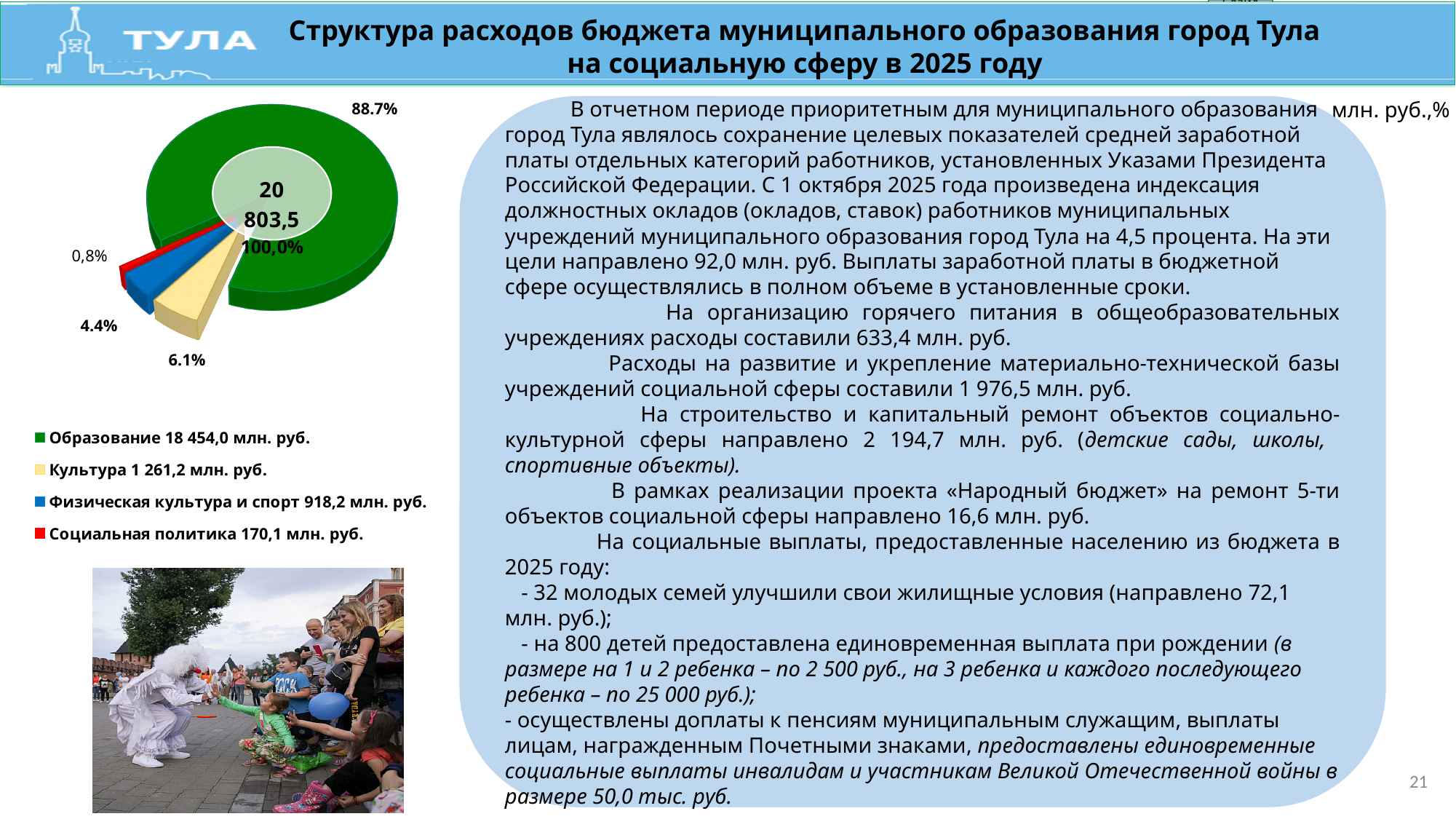
What total value is printed in the centre of the pie chart? 20 803,5 Which slice is larger, Культура or Физическая культура и спорт? Культура What share of the pie does Культура take? 6.1% According to the legend, what is the value for Культура in млн. руб.? 1 261,2 млн. руб. What share of the pie does Социальная политика take? 0,8% What kind of chart is shown on the slide? pie chart Which category has the largest slice of the pie? Образование Which category has the smallest slice of the pie? Социальная политика How many categories does the pie chart's legend list? 4 What share of the pie does Физическая культура и спорт take? 4.4% According to the legend, what is the value for Физическая культура и спорт in млн. руб.? 918,2 млн. руб.